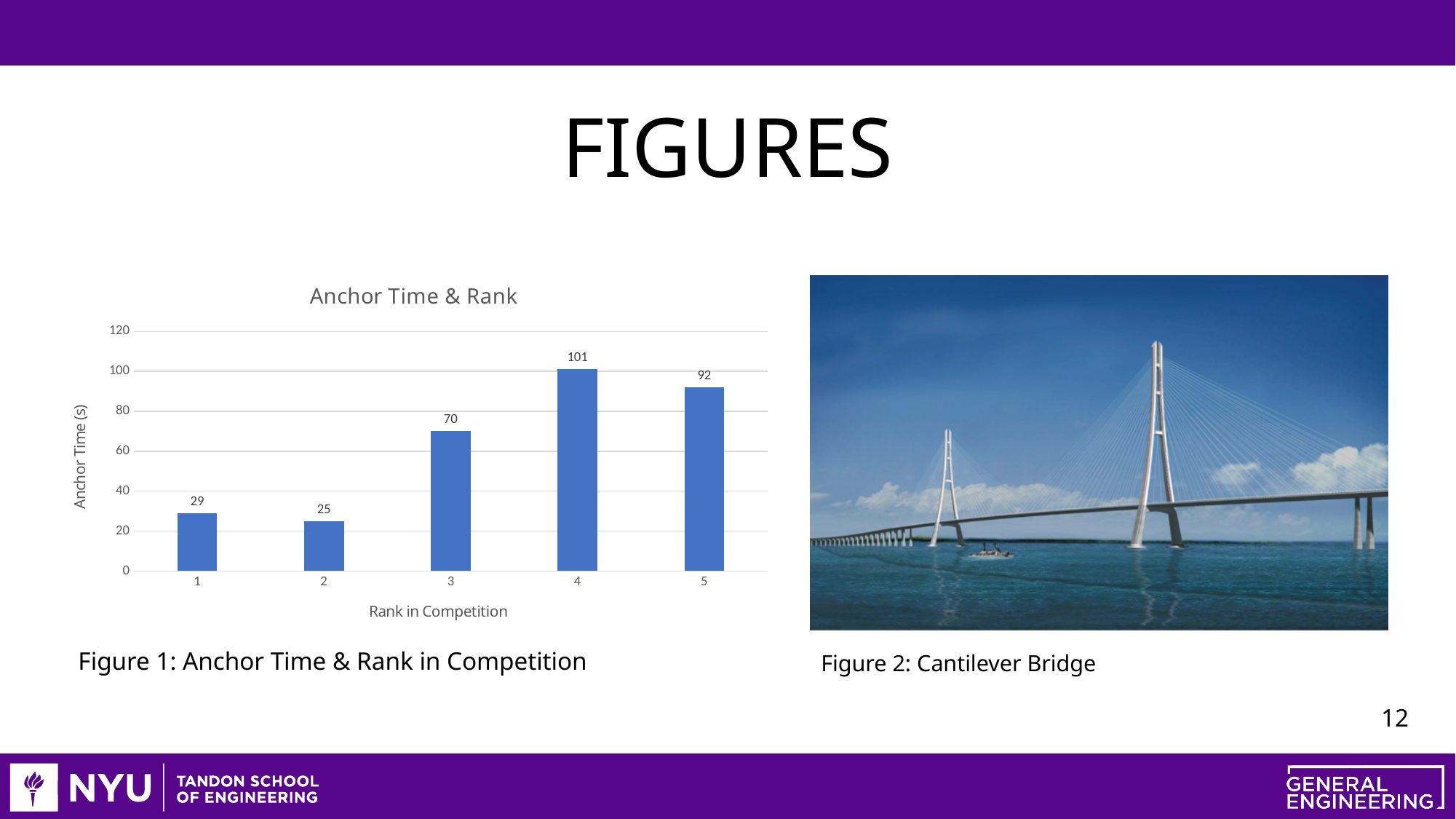
Which rank has the highest anchor time? 4 What is the anchor time for rank 5 in the competition? 92 What is the difference in anchor time between rank 4 and rank 5? 9 Which has a larger anchor time, rank 1 or rank 3? Rank 3 What is the anchor time for rank 4 in the competition? 101 What is the difference in anchor time between rank 3 and rank 2? 45 Which rank has the lowest anchor time? 2 What is the anchor time for rank 1 in the competition? 29 What kind of chart is used to show Anchor Time & Rank? Bar chart What is the label of the y axis of the chart? Anchor Time (s) How many ranks are shown on the x axis of the chart? 5 Is the anchor time for rank 3 greater or less than 60? greater